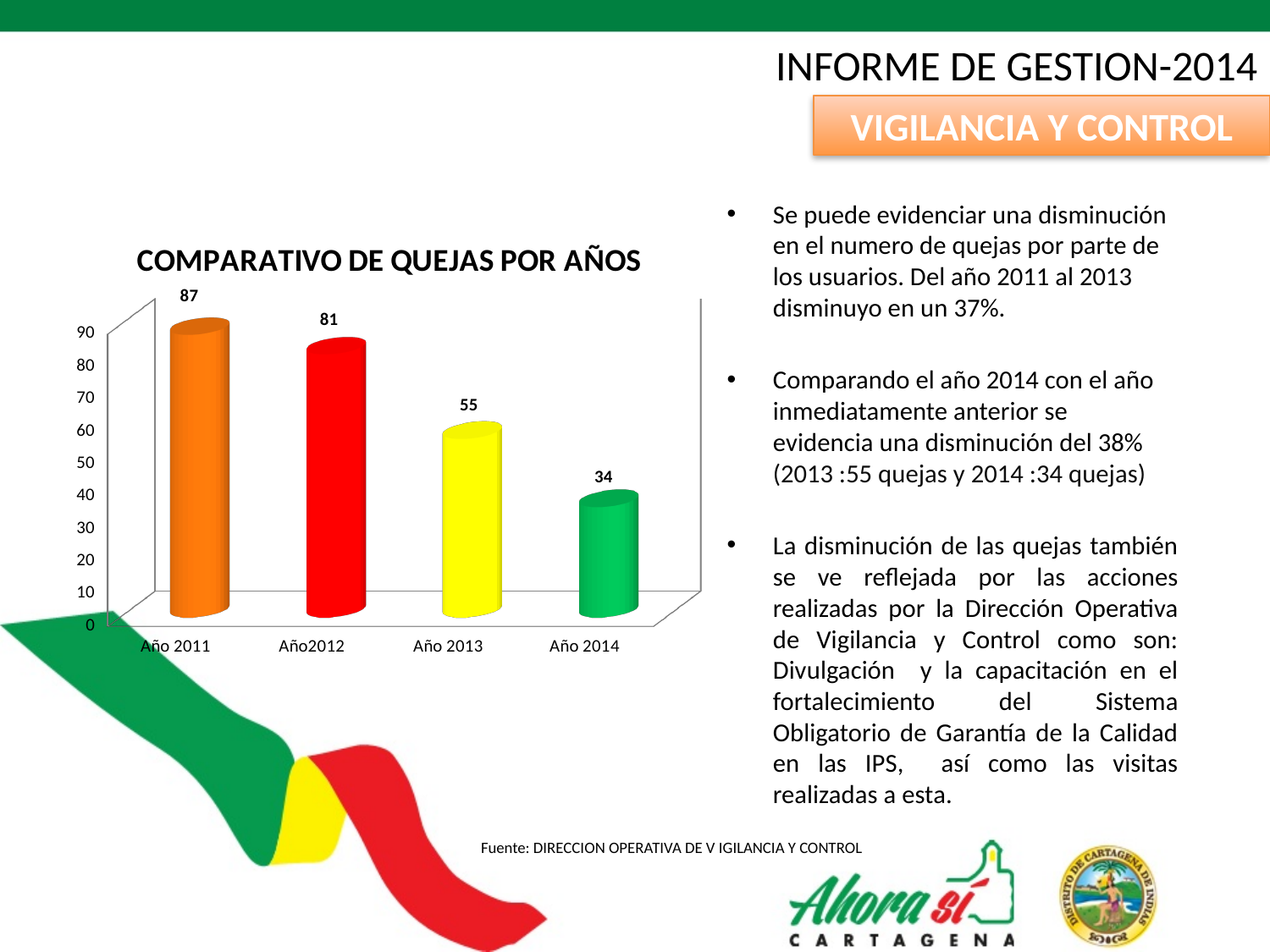
Which year has the highest number of complaints in the chart? Año 2011 What is the difference between the values for Año 2011 and Año2012? 6 What is the value for Año 2013 in the chart? 55 What is the value for Año 2011 in the chart? 87 How many categories are shown in the chart? 4 What is the value for Año2012 in the chart? 81 What is the value for Año 2014 in the chart? 34 Which is larger, the value for Año2012 or the value for Año 2013? Año2012 What kind of chart is shown on the slide? Bar chart What is the difference between the values for Año 2013 and Año 2014? 21 Which year has the lowest number of complaints in the chart? Año 2014 Do the values rise or fall from Año 2011 to Año 2014? Fall